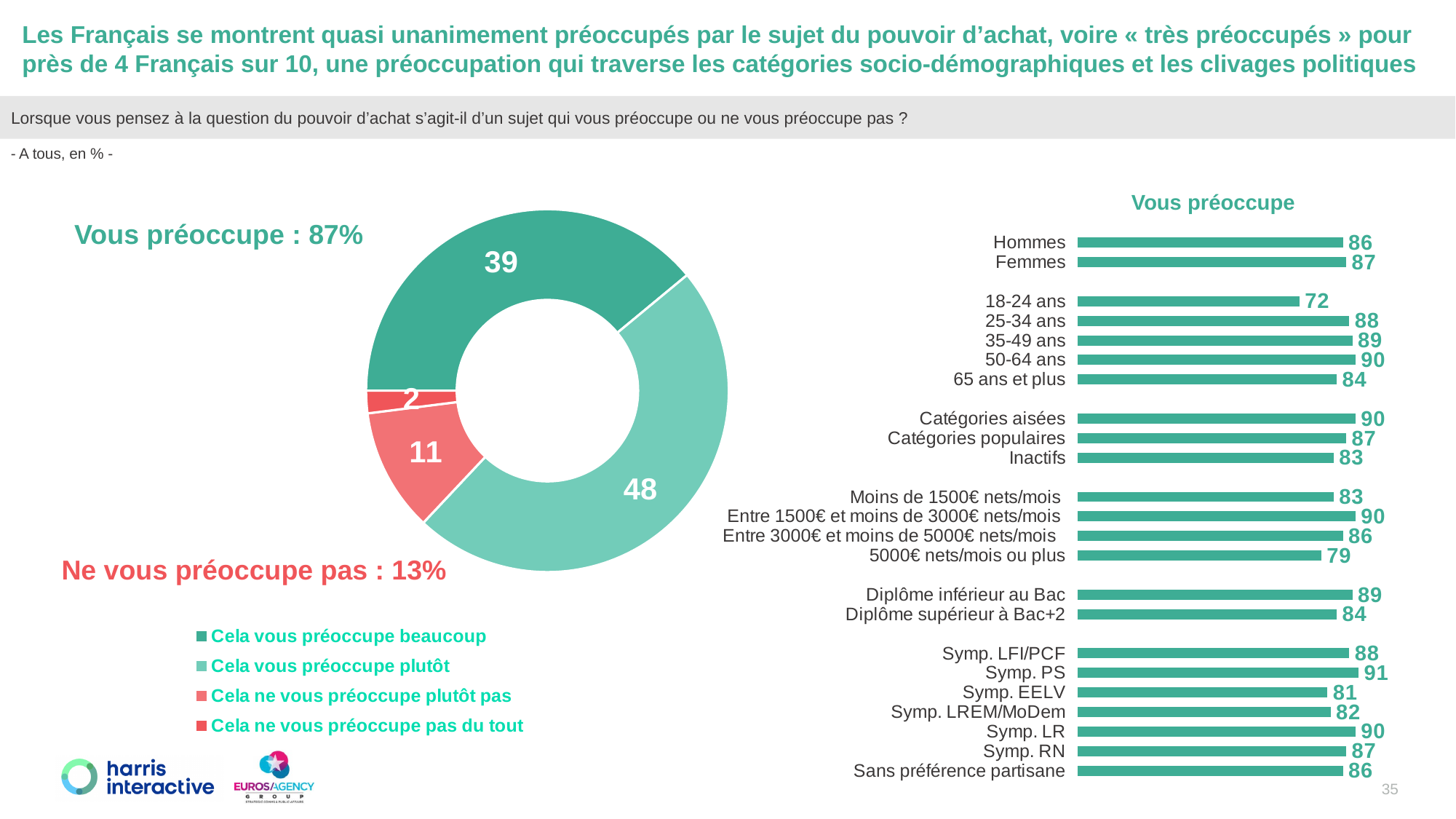
In the donut chart on the left, which response has the largest share? Cela vous préoccupe plutôt In the "Vous préoccupe" bar chart, what is the value for 18-24 ans? 72 In the "Vous préoccupe" bar chart, what is the difference between Hommes and Femmes? 1 In the "Vous préoccupe" bar chart, which category has the lowest value? 18-24 ans In the donut chart on the left, what is the difference between "Cela vous préoccupe plutôt" and "Cela vous préoccupe beaucoup"? 9 In the donut chart on the left, what is the value for "Cela ne vous préoccupe pas du tout"? 2 How many entries does the legend of the donut chart on the left list? 4 In the "Vous préoccupe" bar chart, how many categories are plotted? 23 In the "Vous préoccupe" bar chart, what is the value for Symp. PS? 91 In the "Vous préoccupe" bar chart, which is larger: Catégories aisées or Inactifs? Catégories aisées What type of chart is the "Vous préoccupe" chart on the right? Bar chart In the donut chart on the left, what percentage of respondents answered "Cela vous préoccupe plutôt"? 48